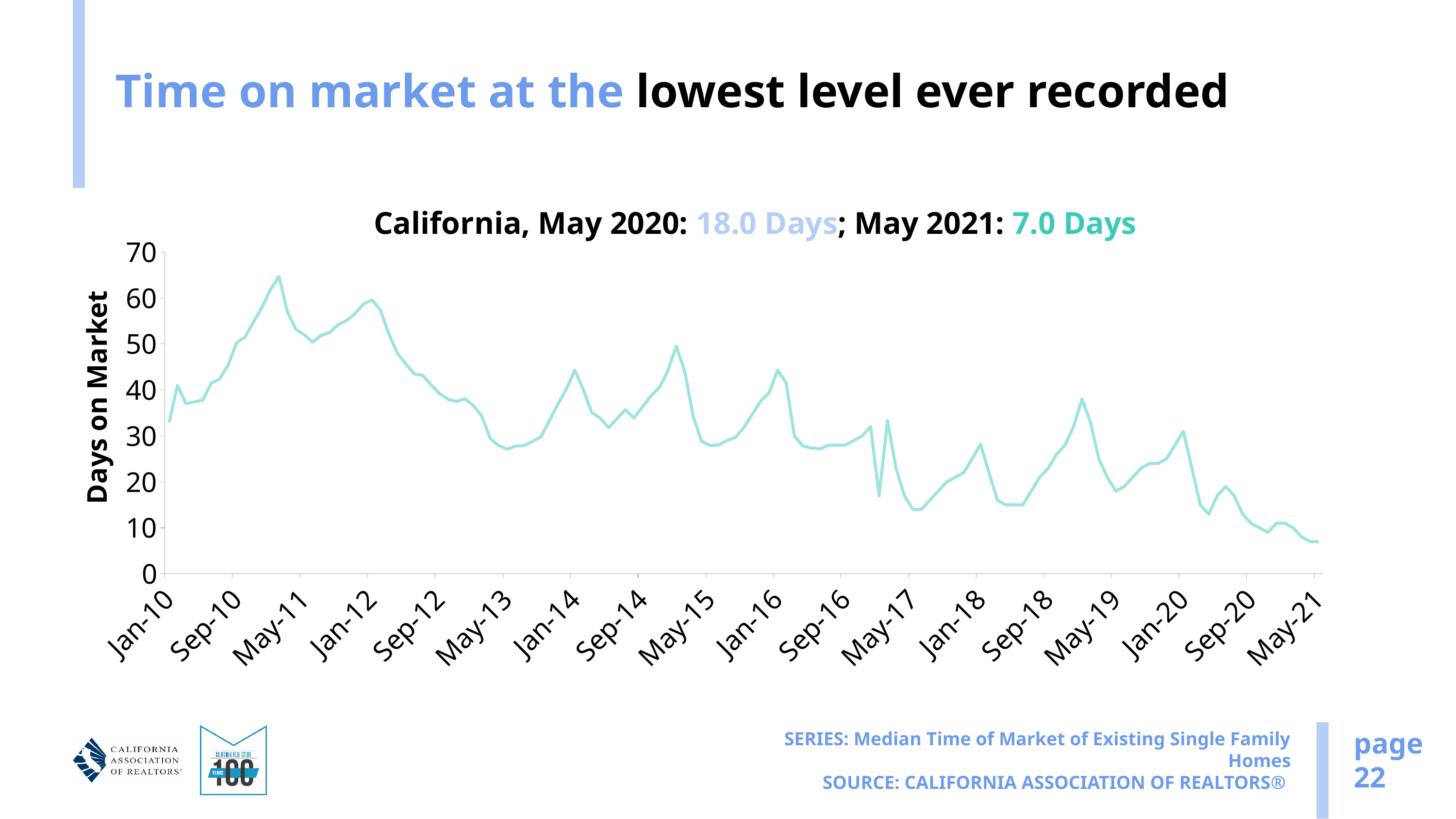
Is the value for Jan-20 greater or less than 20? greater What kind of chart is shown on the slide? line chart What was the median time on market in California in May 2021? 7.0 Days What is the label on the vertical axis? Days on Market What was the median time on market in California in May 2020? 18.0 Days Overall, do the values rise or fall from Jan-10 to May-21? fall Which was higher, the time on market in May 2020 or in May 2021? May 2020 Is the value for May-17 greater or less than 20? less Which labeled month on the x axis has the lowest value? May-21 Is the value for Jan-12 greater or less than 50? greater By how many days did the median time on market fall from May 2020 to May 2021? 11.0 days